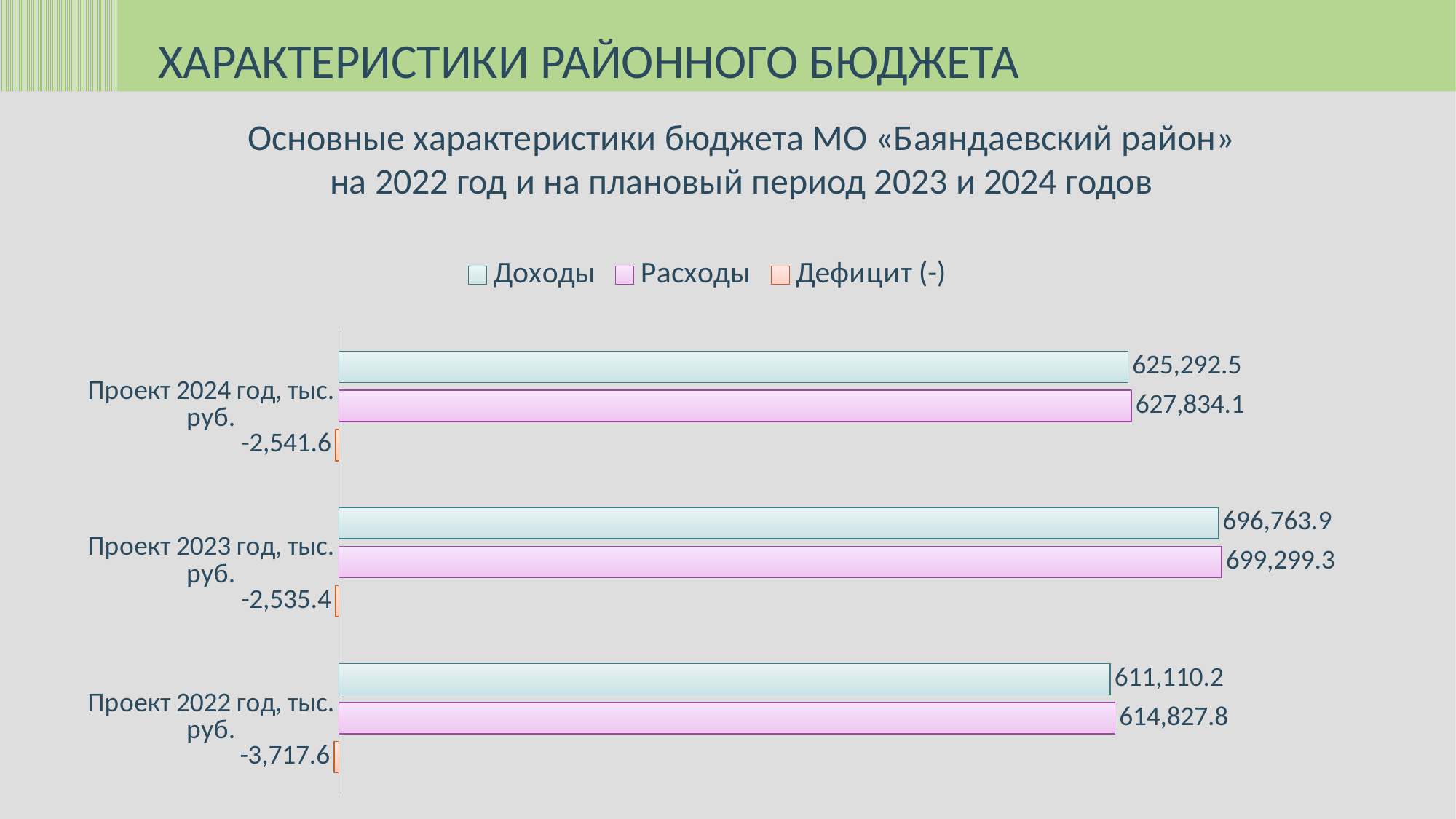
How many categories (years) are shown on the chart? 3 Which year has the highest Расходы value? Проект 2023 год, тыс. руб. Which year has the lowest Доходы value? Проект 2022 год, тыс. руб. What type of chart is shown on the slide? Bar chart What is the value of Расходы for Проект 2022 год, тыс. руб.? 614,827.8 What is the difference between Расходы and Доходы for Проект 2023 год, тыс. руб.? 2,535.4 What is the value of Дефицит (-) for Проект 2024 год, тыс. руб.? -2,541.6 What is the value of Доходы for Проект 2023 год, тыс. руб.? 696,763.9 Which is larger for Проект 2024 год, тыс. руб.: Доходы or Расходы? Расходы Which series is shown in pink on the chart? Расходы What is the difference between the Доходы values for Проект 2023 год and Проект 2024 год? 71,471.4 How many series does the legend list? 3